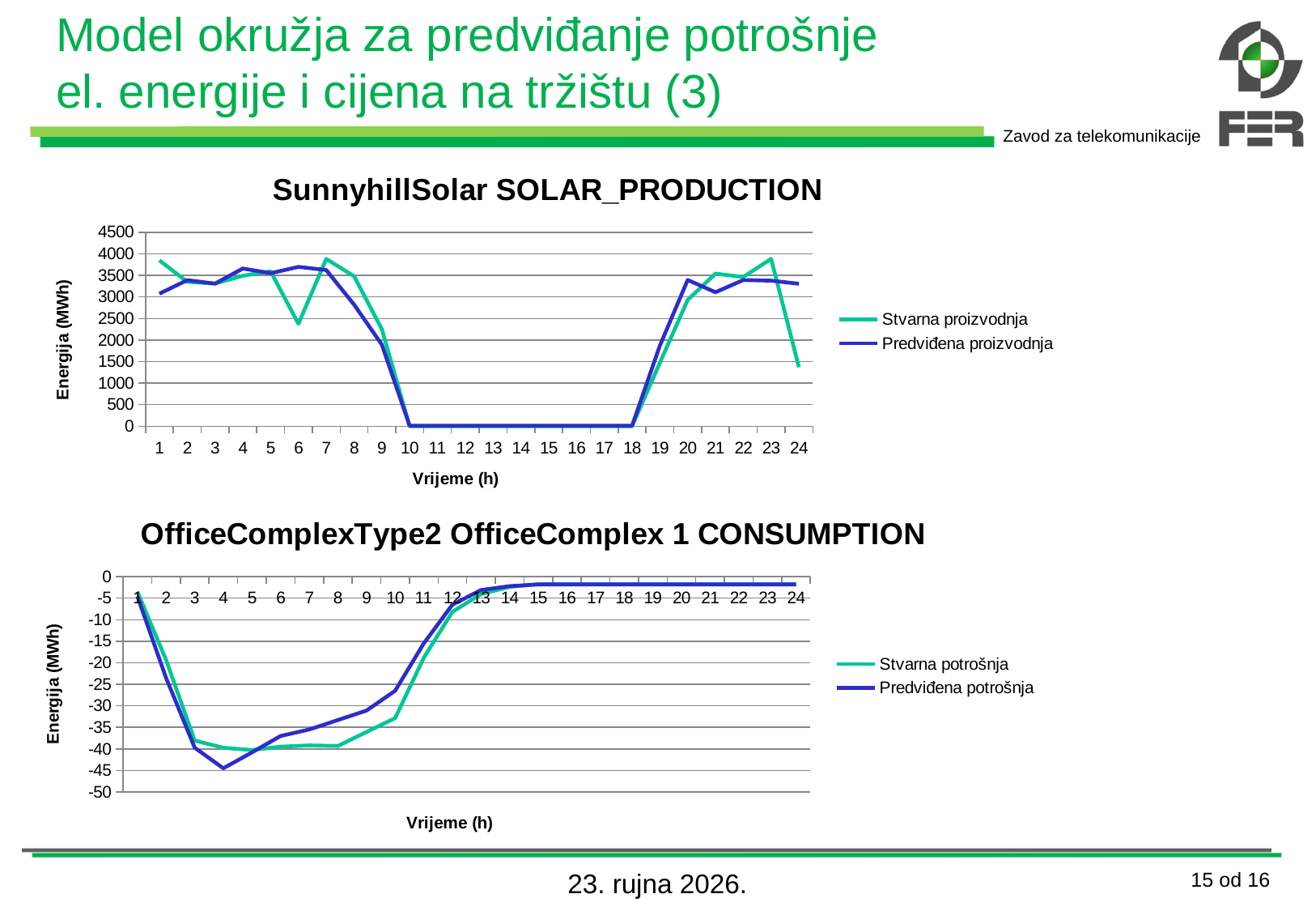
In the SunnyhillSolar SOLAR_PRODUCTION chart, which series has the higher value at hour 6, Stvarna proizvodnja or Predviđena proizvodnja? Predviđena proizvodnja In the SunnyhillSolar SOLAR_PRODUCTION chart, is the value of Stvarna proizvodnja at hour 6 greater or less than 3000? less How many time points are shown on the x axis of the OfficeComplexType2 OfficeComplex 1 CONSUMPTION chart? 24 What kind of chart is the SunnyhillSolar SOLAR_PRODUCTION chart? line chart What is the y-axis label of the OfficeComplexType2 OfficeComplex 1 CONSUMPTION chart? Energija (MWh) In the SunnyhillSolar SOLAR_PRODUCTION chart, which series has the higher value at hour 24, Stvarna proizvodnja or Predviđena proizvodnja? Predviđena proizvodnja In the OfficeComplexType2 OfficeComplex 1 CONSUMPTION chart, which series has the higher value at hour 8, Stvarna potrošnja or Predviđena potrošnja? Predviđena potrošnja In the SunnyhillSolar SOLAR_PRODUCTION chart, do the values of Stvarna proizvodnja rise or fall from hour 7 to hour 10? fall In the OfficeComplexType2 OfficeComplex 1 CONSUMPTION chart, do the values of Stvarna potrošnja rise or fall from hour 9 to hour 13? rise How many series does the legend of the SunnyhillSolar SOLAR_PRODUCTION chart list? 2 In the OfficeComplexType2 OfficeComplex 1 CONSUMPTION chart, is the value of Predviđena potrošnja at hour 4 greater or less than -40? less In the SunnyhillSolar SOLAR_PRODUCTION chart, is the value of Stvarna proizvodnja at hour 24 greater or less than 2000? less